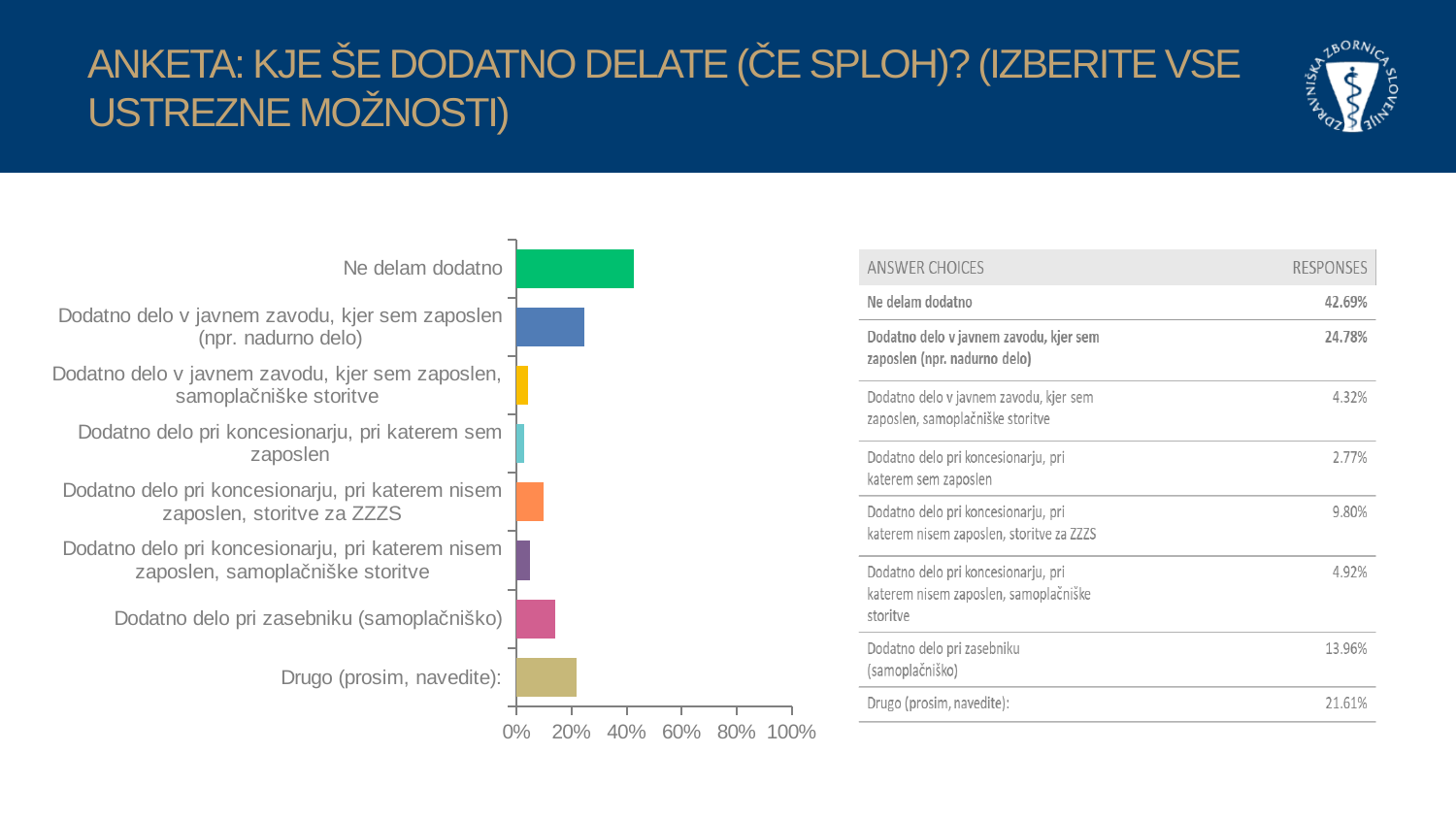
What kind of chart is shown on the slide? bar chart How many answer choices (categories) does the bar chart show? 8 Is the value for "Ne delam dodatno" greater or less than 40%? greater Is the value for "Dodatno delo pri zasebniku (samoplačniško)" greater or less than 20%? less Which answer choice has the highest response share? Ne delam dodatno What is the response share for "Dodatno delo pri koncesionarju, pri katerem nisem zaposlen, storitve za ZZZS"? 9.80% What is the response share for "Ne delam dodatno"? 42.69% Which answer choice has the lowest response share? Dodatno delo pri koncesionarju, pri katerem sem zaposlen What is the difference between the response shares for "Ne delam dodatno" and "Dodatno delo v javnem zavodu, kjer sem zaposlen (npr. nadurno delo)"? 17.91% What is the response share for "Drugo (prosim, navedite):"? 21.61% Which is larger: the response share for "Dodatno delo v javnem zavodu, kjer sem zaposlen (npr. nadurno delo)" or for "Drugo (prosim, navedite):"? Dodatno delo v javnem zavodu, kjer sem zaposlen (npr. nadurno delo) What is the response share for "Dodatno delo pri zasebniku (samoplačniško)"? 13.96%